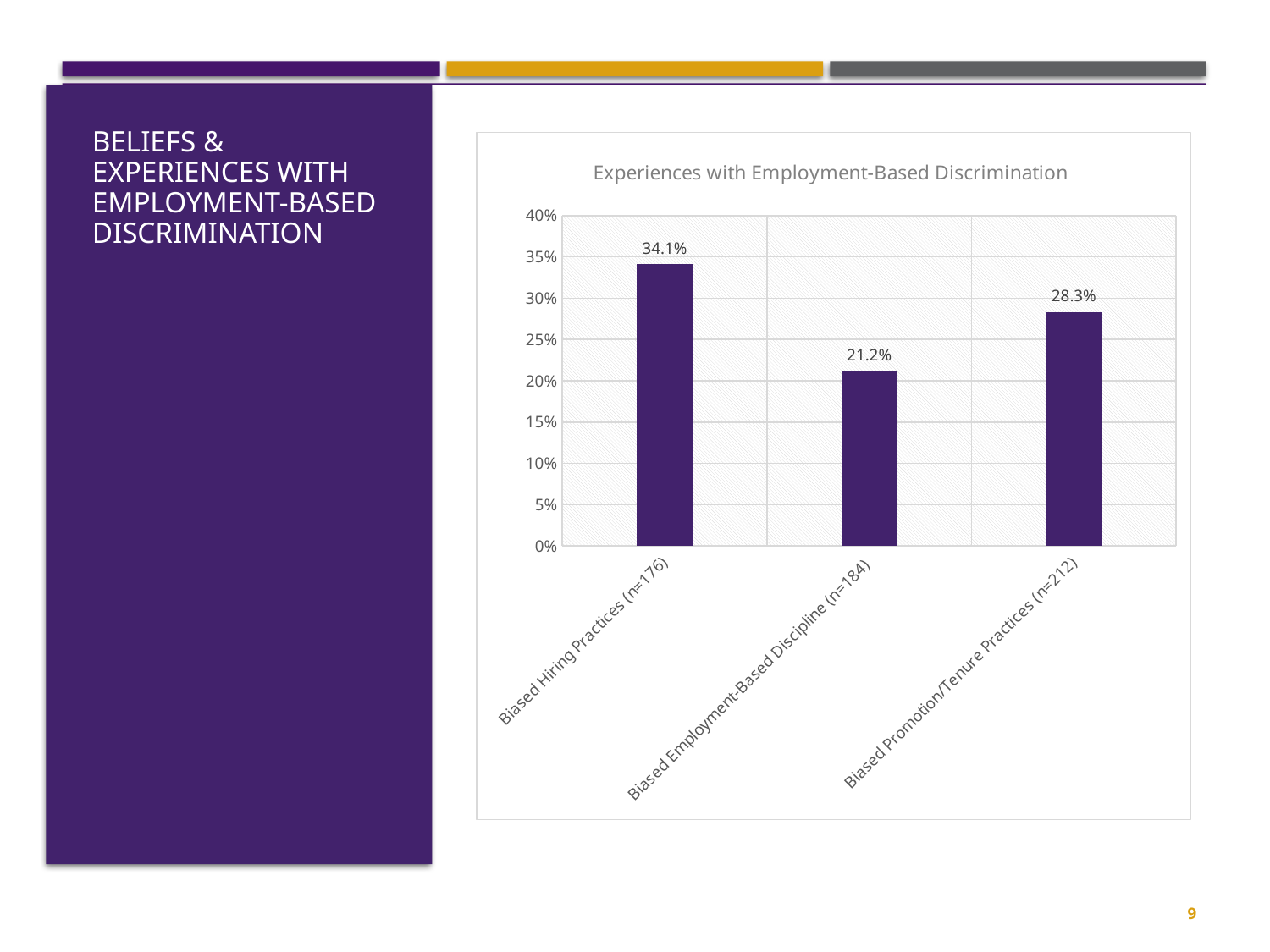
Is the value for Biased Promotion/Tenure Practices (n=212) greater or less than 30%? less Which category has the lowest value? Biased Employment-Based Discipline (n=184) Which category has the highest value? Biased Hiring Practices (n=176) How many categories are shown in the chart? 3 What is the difference between the values for Biased Hiring Practices (n=176) and Biased Employment-Based Discipline (n=184)? 12.9% What kind of chart is shown on the slide? bar chart What is the value for Biased Hiring Practices (n=176)? 34.1% What is the title of the chart? Experiences with Employment-Based Discrimination What is the value for Biased Promotion/Tenure Practices (n=212)? 28.3% What is the value for Biased Employment-Based Discipline (n=184)? 21.2% What is the difference between the values for Biased Promotion/Tenure Practices (n=212) and Biased Employment-Based Discipline (n=184)? 7.1% Which is larger, the value for Biased Promotion/Tenure Practices (n=212) or Biased Employment-Based Discipline (n=184)? Biased Promotion/Tenure Practices (n=212)